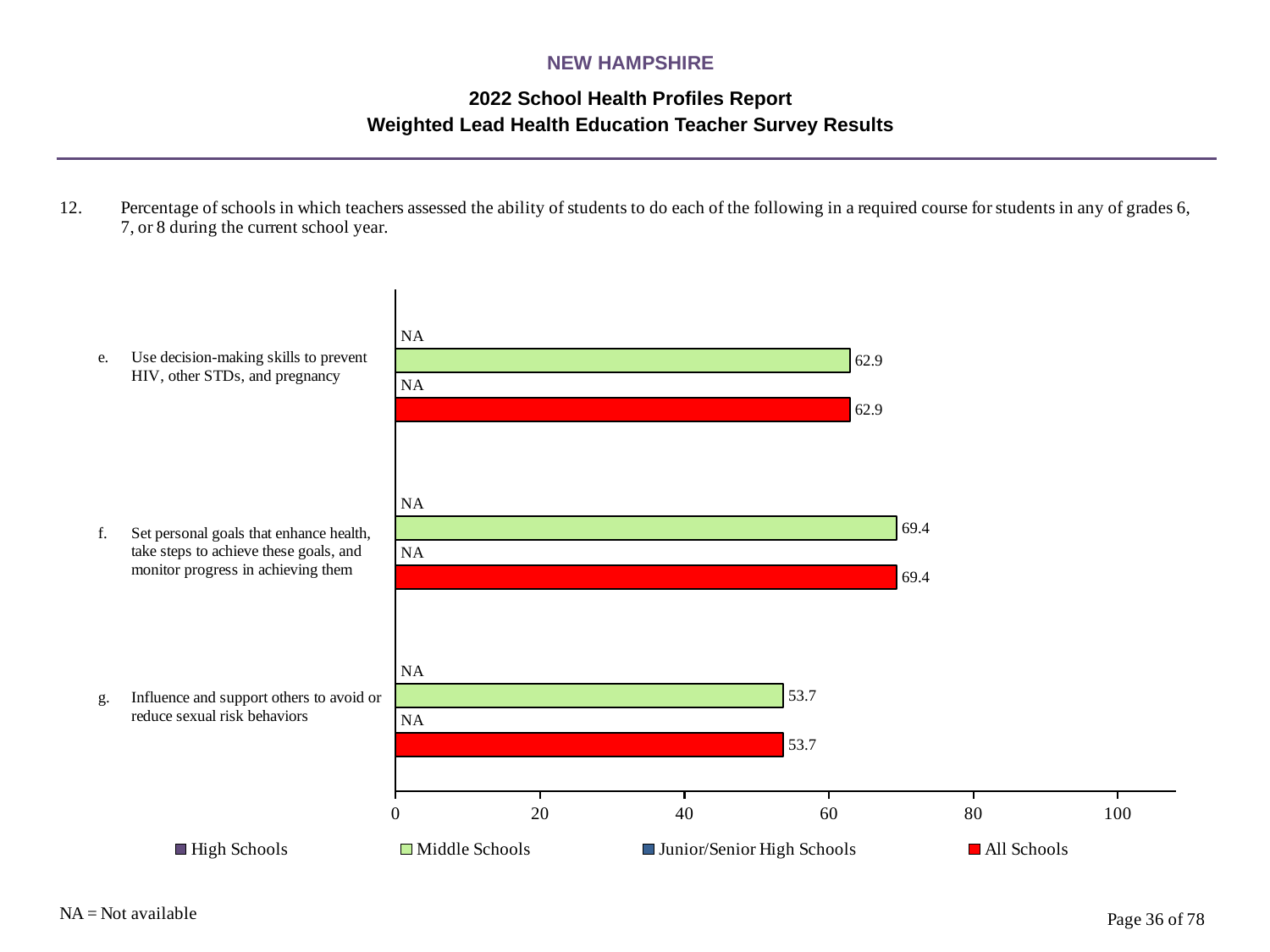
What is the Middle Schools value for 'Influence and support others to avoid or reduce sexual risk behaviors'? 53.7 What is the difference between the Middle Schools values for 'Set personal goals that enhance health...' and 'Influence and support others to avoid or reduce sexual risk behaviors'? 15.7 How many series does the legend list? 4 Which category has the lowest All Schools value? Influence and support others to avoid or reduce sexual risk behaviors How many categories are shown on the chart? 3 What is the Middle Schools value for 'Use decision-making skills to prevent HIV, other STDs, and pregnancy'? 62.9 Is the Middle Schools value for 'Use decision-making skills to prevent HIV, other STDs, and pregnancy' greater or less than 60? greater What kind of chart is shown on the slide? bar chart What is the All Schools value for 'Set personal goals that enhance health, take steps to achieve these goals, and monitor progress in achieving them'? 69.4 Which is larger: the All Schools value for 'Use decision-making skills to prevent HIV, other STDs, and pregnancy' or for 'Influence and support others to avoid or reduce sexual risk behaviors'? Use decision-making skills to prevent HIV, other STDs, and pregnancy Which category has the highest Middle Schools value? Set personal goals that enhance health, take steps to achieve these goals, and monitor progress in achieving them What value is shown for High Schools for 'Set personal goals that enhance health, take steps to achieve these goals, and monitor progress in achieving them'? NA